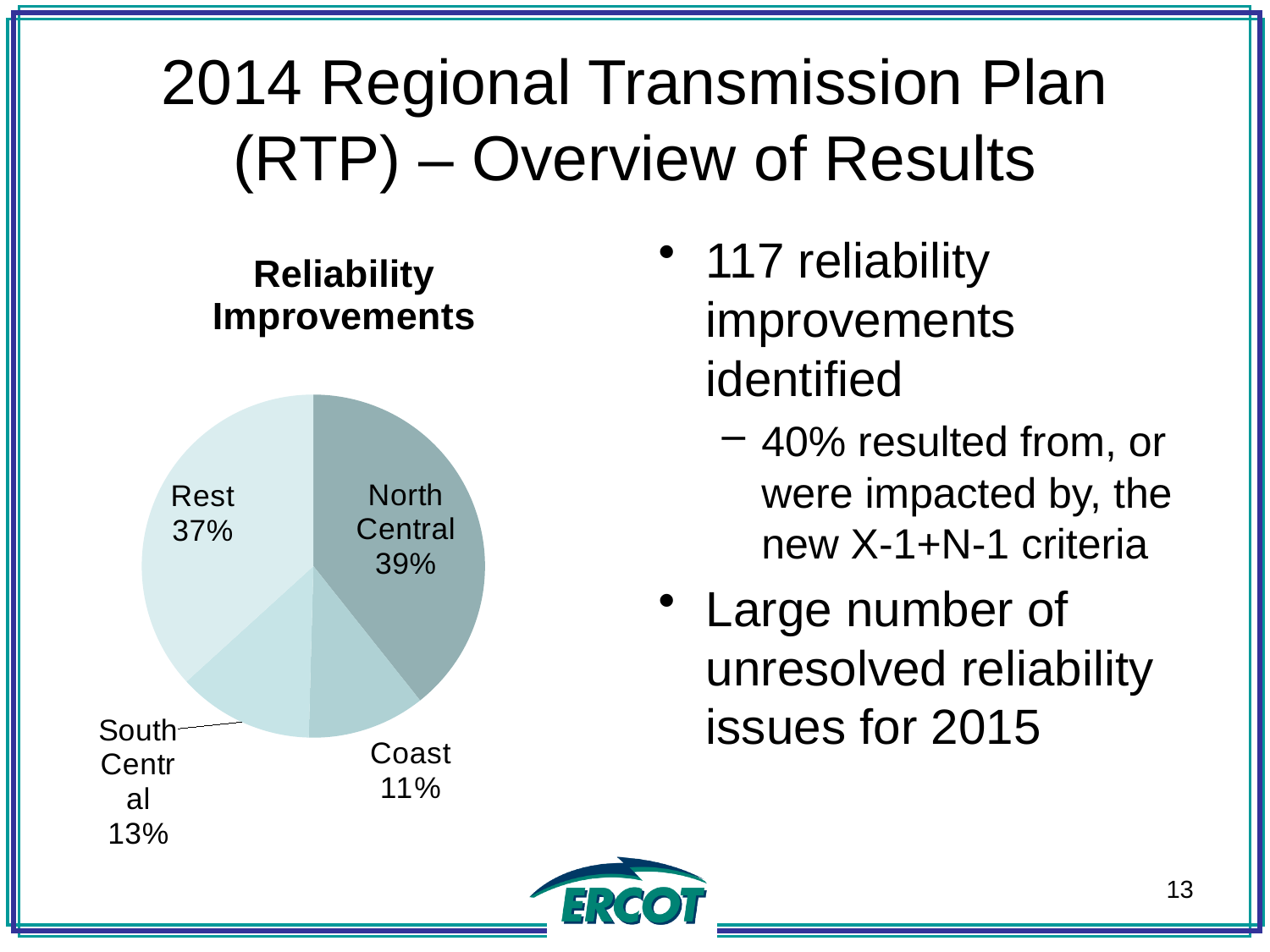
How many slices does the pie chart have? 4 Which slice is larger, South Central or Coast? South Central What kind of chart is shown on the slide? pie chart What is the combined share of the North Central and Rest slices? 76% What is the title of the chart? Reliability Improvements What share of reliability improvements is attributed to North Central? 39% What is the difference in percentage points between the North Central and Coast slices? 28 What share of reliability improvements is attributed to South Central? 13% Which region has the largest slice of the pie? North Central Which region has the smallest slice of the pie? Coast What share of reliability improvements is attributed to Rest? 37% What share of reliability improvements is attributed to Coast? 11%